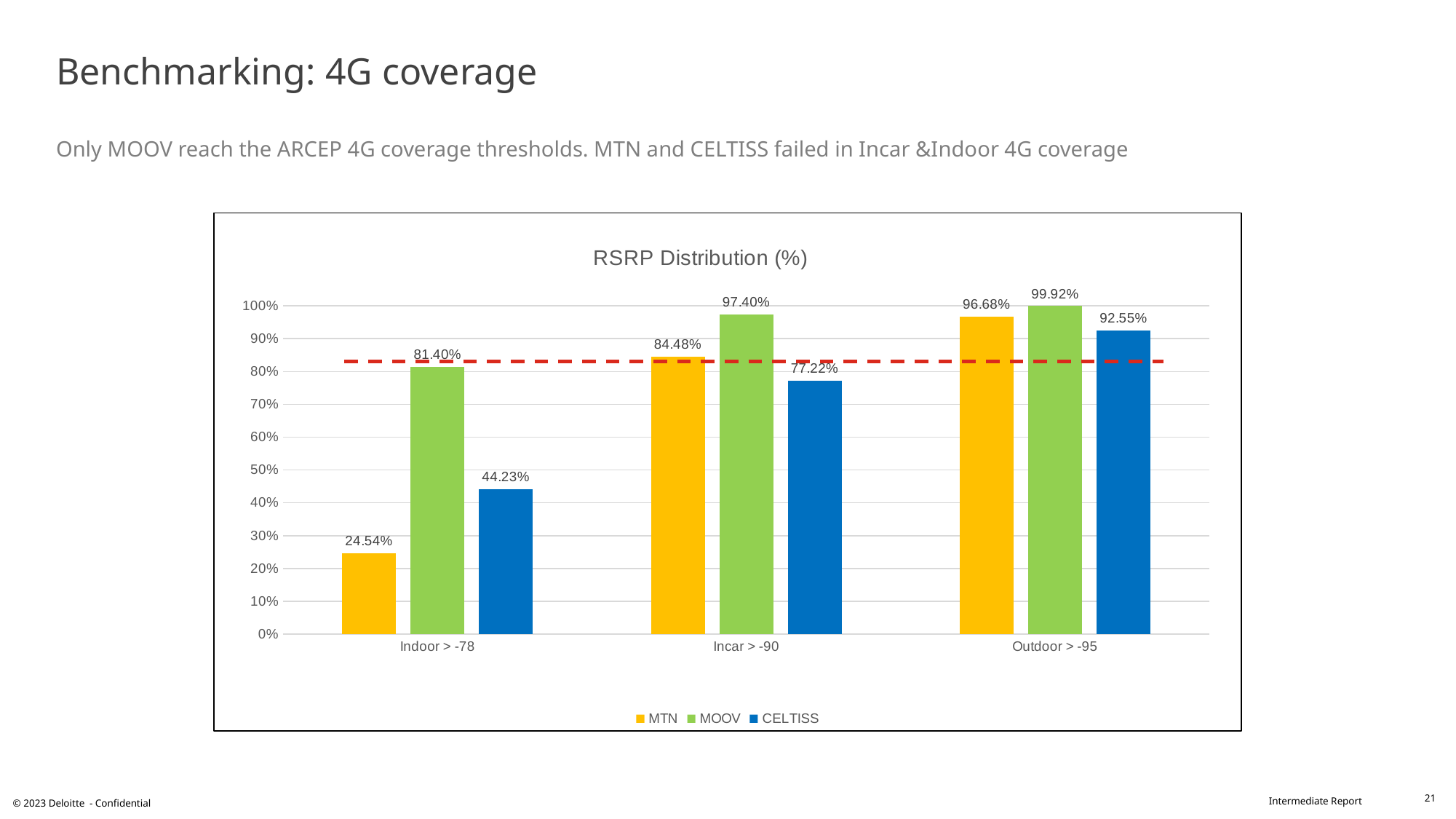
How many series does the legend list? 3 How many categories are shown on the x axis? 3 Which operator has the lowest value in the Outdoor > -95 category? CELTISS What kind of chart is shown on the slide? bar chart What is the value for MOOV in the Outdoor > -95 category? 99.92% Which is larger in the Incar > -90 category: MTN or CELTISS? MTN Is the value for CELTISS in the Indoor > -78 category greater or less than 50%? less What is the title of the chart? RSRP Distribution (%) What is the difference between MOOV and MTN in the Indoor > -78 category? 56.86% What is the value for CELTISS in the Incar > -90 category? 77.22% Which operator has the highest value in the Indoor > -78 category? MOOV What is the value for MTN in the Indoor > -78 category? 24.54%